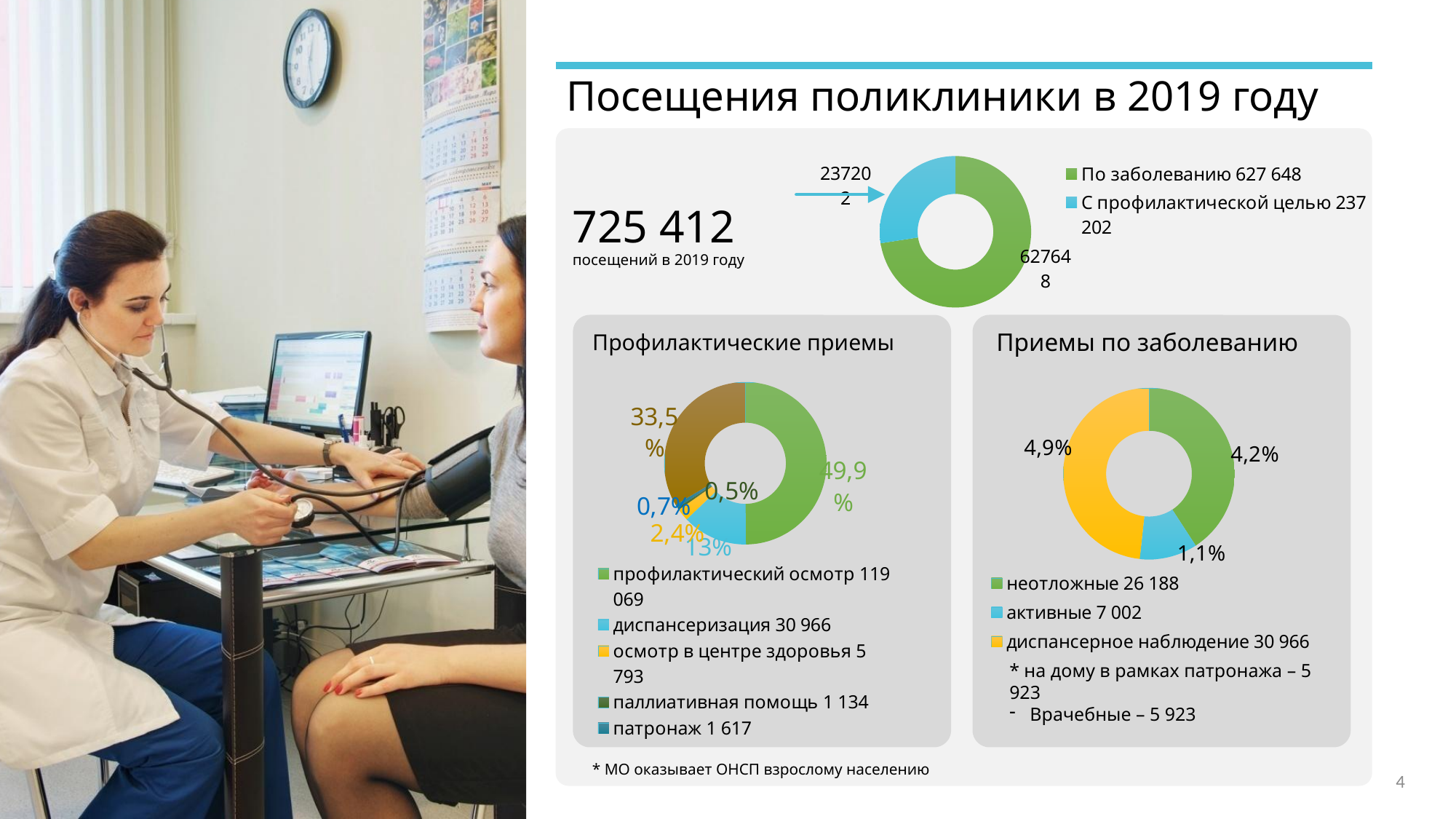
What kind of chart is used in the «Профилактические приемы» panel? Doughnut (pie) chart In the «Профилактические приемы» chart, what is the value for «диспансеризация»? 30 966 In the top donut chart, what is the value for «По заболеванию»? 627 648 In the «Профилактические приемы» chart, which legend category has the lowest value? паллиативная помощь In the «Приемы по заболеванию» chart, what is the value for «неотложные»? 26 188 In the top donut chart, what is the difference between «По заболеванию» and «С профилактической целью»? 390 446 How many entries does the legend of the top donut chart list? 2 In the «Приемы по заболеванию» chart, what is the difference between «диспансерное наблюдение» and «активные»? 23 964 In the top donut chart, which is larger: «По заболеванию» or «С профилактической целью»? По заболеванию In the top donut chart, what is the value for «С профилактической целью»? 237 202 In the «Приемы по заболеванию» chart, which category has the highest value? диспансерное наблюдение In the «Профилактические приемы» chart, what share does «профилактический осмотр» have? 49,9%